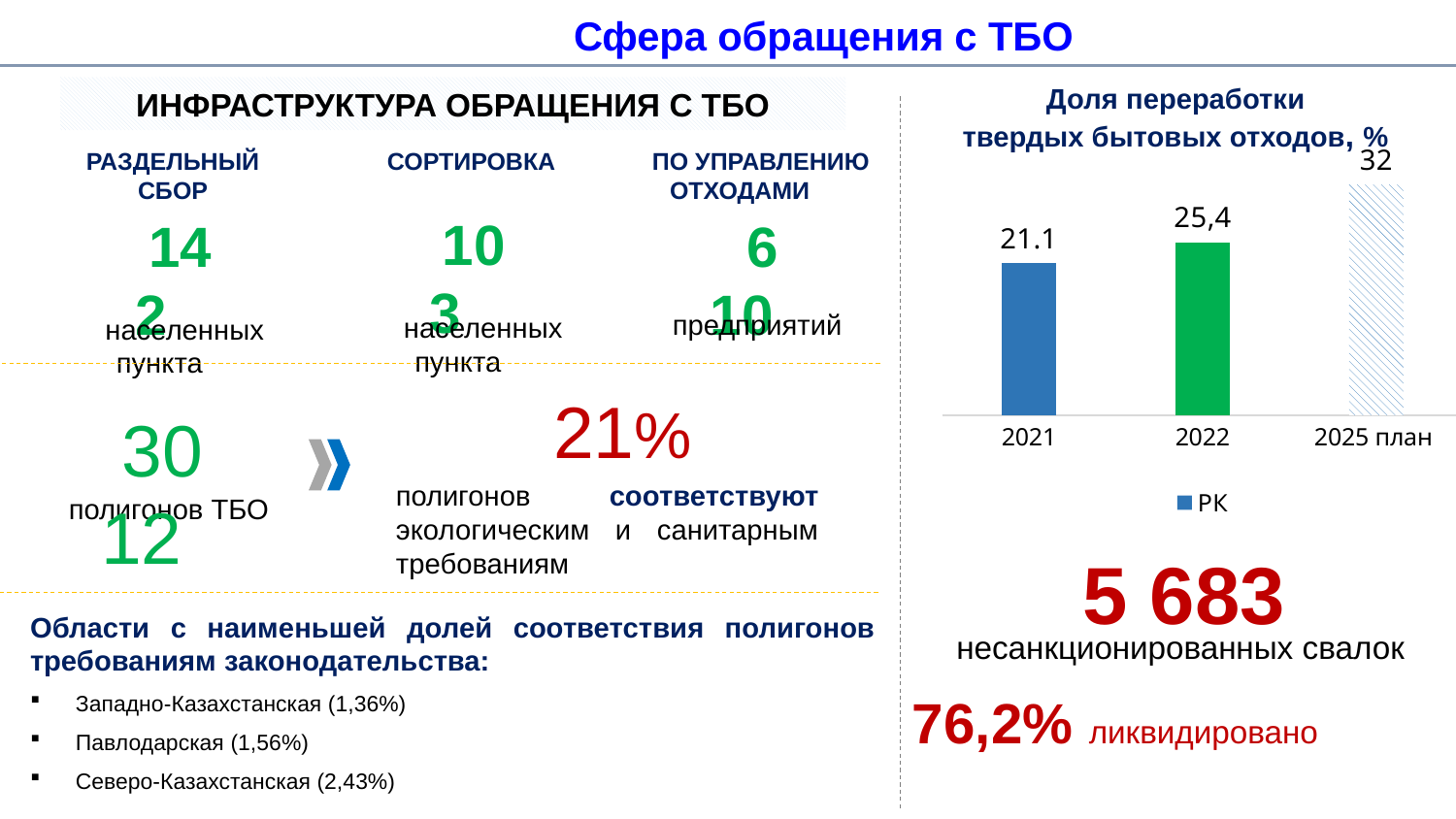
How many categories are shown on the x axis of the chart "Доля переработки твердых бытовых отходов, %"? 3 In the chart "Доля переработки твердых бытовых отходов, %", which is larger: the value for 2022 or the value for 2021? 2022 What type of chart is shown under the title "Доля переработки твердых бытовых отходов, %"? bar chart In the chart "Доля переработки твердых бытовых отходов, %", what is the value for 2021? 21.1 What is the legend entry of the chart "Доля переработки твердых бытовых отходов, %"? РК In the chart "Доля переработки твердых бытовых отходов, %", what is the value for 2025 план? 32 In the chart "Доля переработки твердых бытовых отходов, %", which category has the highest value? 2025 план How many series does the legend of the chart "Доля переработки твердых бытовых отходов, %" list? 1 In the chart "Доля переработки твердых бытовых отходов, %", what is the difference between the 2025 план value and the 2022 value? 6,6 Do the values in the chart "Доля переработки твердых бытовых отходов, %" rise or fall from 2021 to 2025 план? rise In the chart "Доля переработки твердых бытовых отходов, %", what is the value for 2022? 25,4 In the chart "Доля переработки твердых бытовых отходов, %", which category has the lowest value? 2021